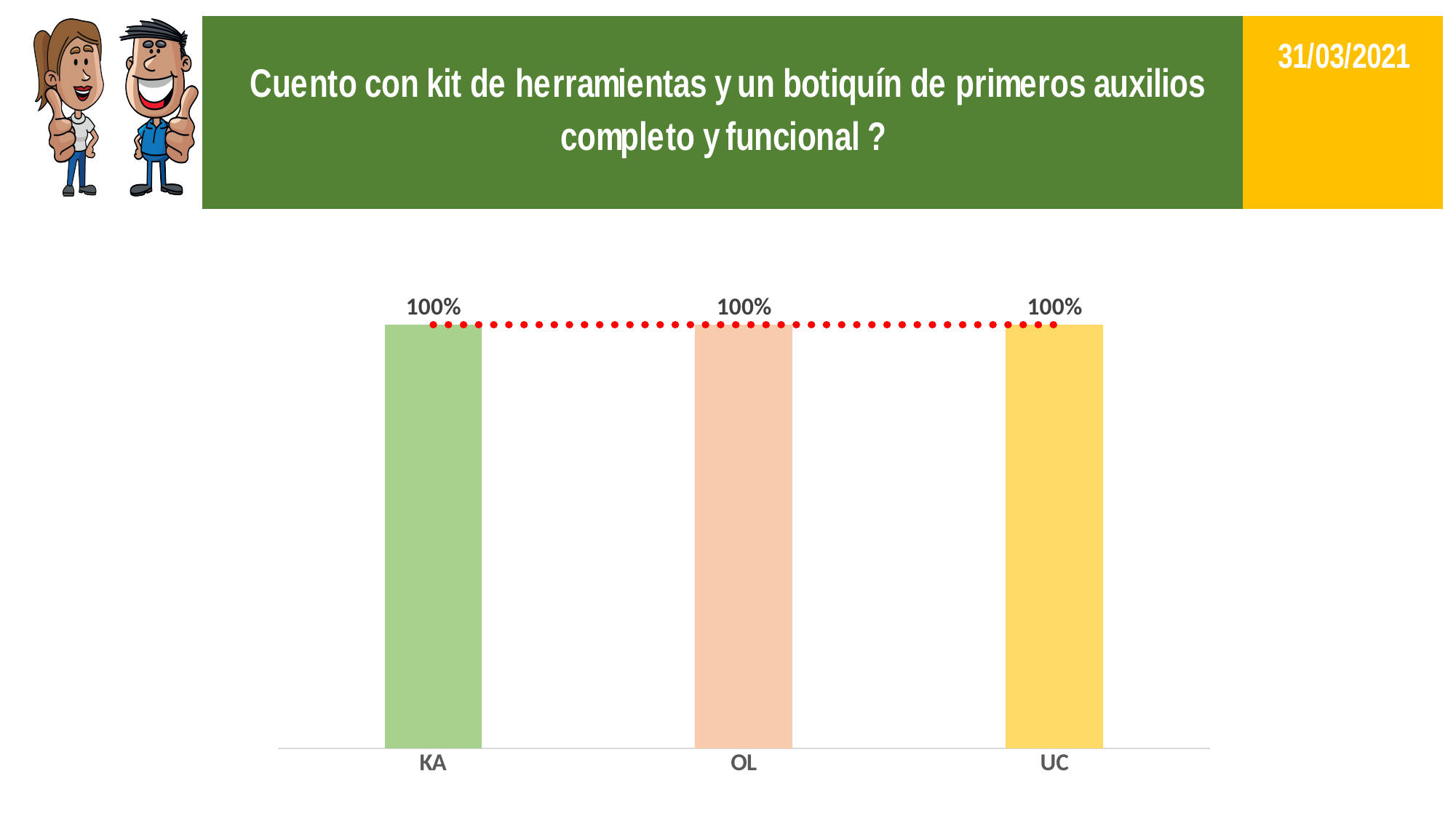
What is the value for KA? 100% What kind of chart is shown on the slide? bar chart Do the values rise, fall or stay the same from KA to UC? stay the same Do all three bars have the same value? yes What is the value for OL? 100% What colour is the bar for OL? orange What is the difference between the values for KA and UC? 0% How many categories are shown on the x axis? 3 What is the value for UC? 100% What date is shown in the top right corner of the slide? 31/03/2021